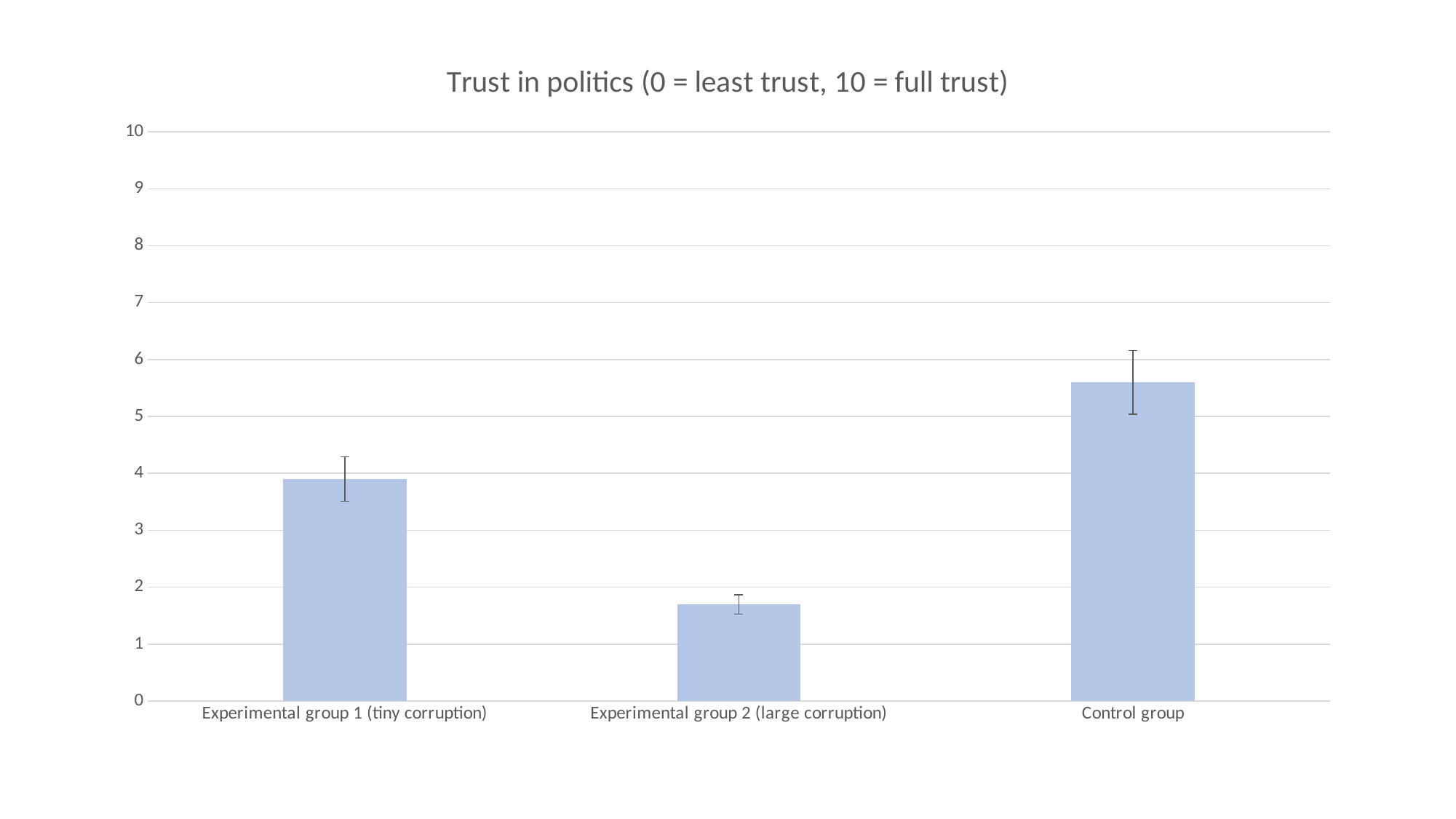
Which is larger, the value for Control group or Experimental group 1 (tiny corruption)? Control group How many groups are shown on the x axis? 3 What kind of chart is shown on the slide? bar chart What is the maximum value shown on the y axis? 10 Is the value for Control group greater or less than 5? greater Which group has the highest trust in politics? Control group Which is larger, the value for Experimental group 1 (tiny corruption) or Experimental group 2 (large corruption)? Experimental group 1 (tiny corruption) Which group has the lowest trust in politics? Experimental group 2 (large corruption) Is the value for Experimental group 1 (tiny corruption) greater or less than 3? greater Is the value for Experimental group 2 (large corruption) greater or less than 2? less What is the title of the chart? Trust in politics (0 = least trust, 10 = full trust)